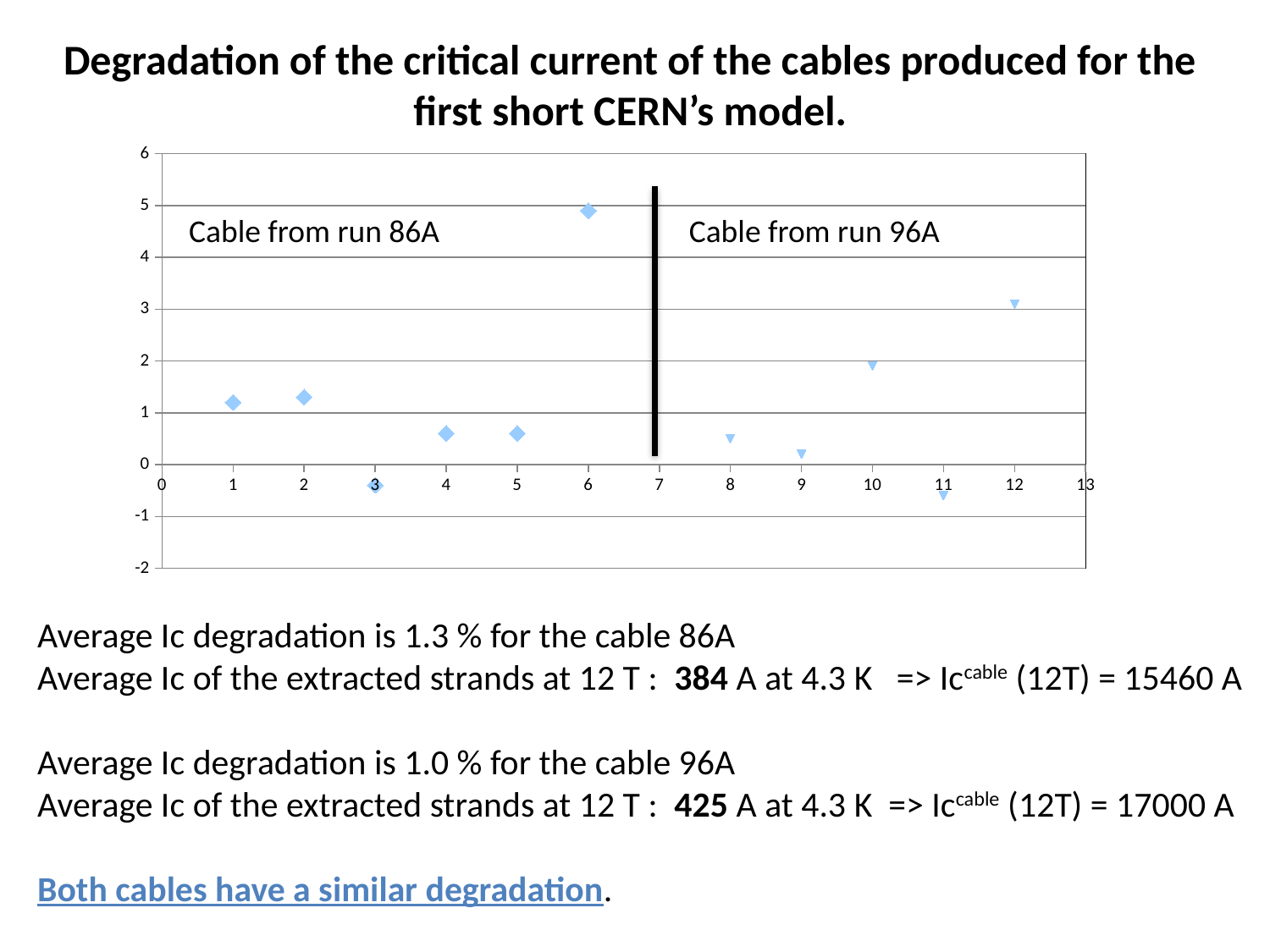
Which plotted value is larger, the one at x = 10 or the one at x = 8? x = 10 What kind of chart is shown on the slide? scatter chart How many data points are plotted in the chart in total? 11 How many data points are plotted in the 'Cable from run 86A' section of the chart? 6 At which x-axis position is the highest plotted value? 6 Is the value plotted at x = 12 greater or less than 2? greater Is the value plotted at x = 9 greater or less than 1? less Is the value plotted at x = 6 greater or less than 4? greater What label is shown in the right-hand section of the chart, to the right of the vertical black line? Cable from run 96A Which plotted value is larger, the one at x = 6 or the one at x = 12? x = 6